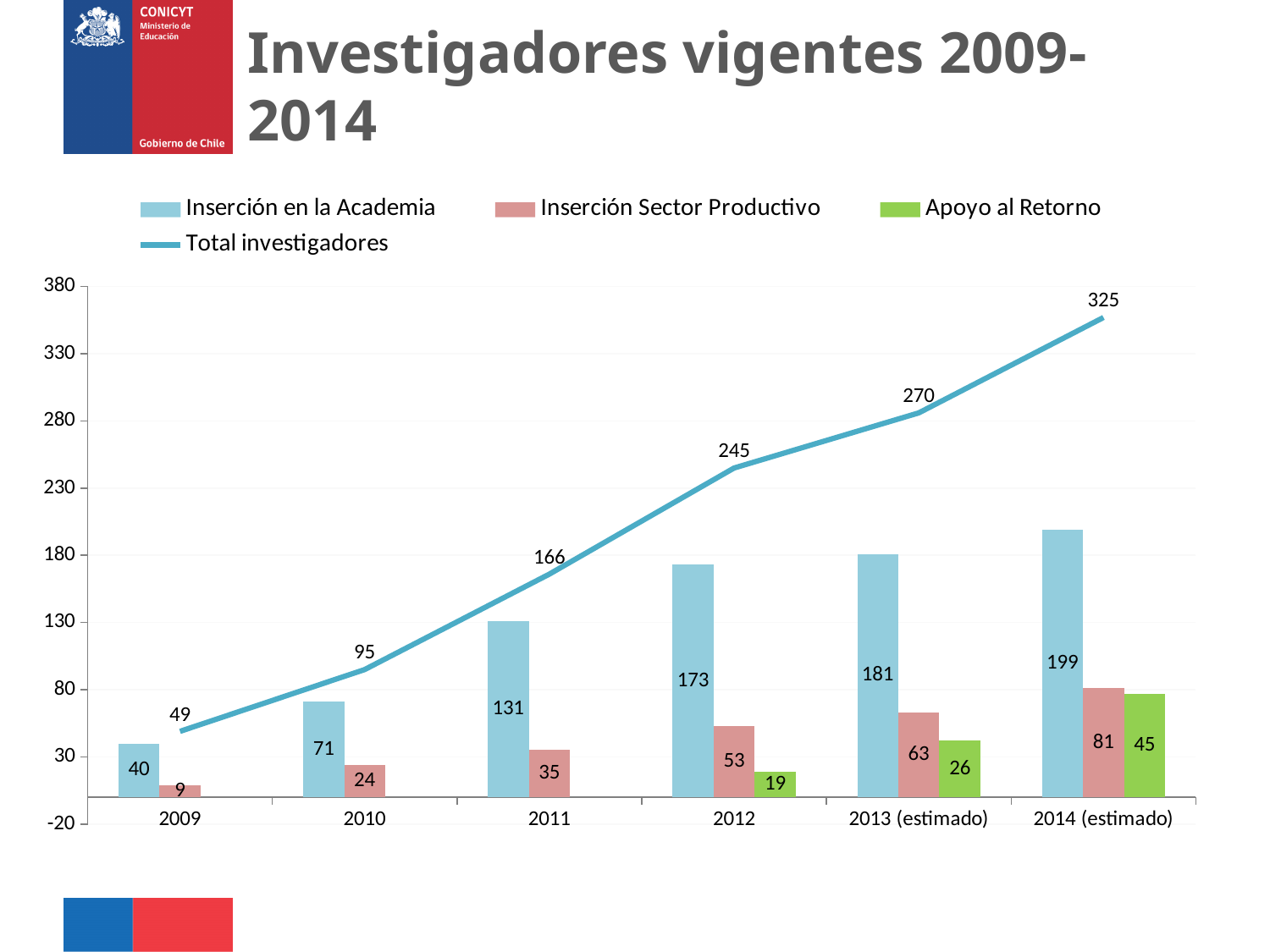
What is the value of Apoyo al Retorno in 2013 (estimado)? 26 What is the Total investigadores value for 2014 (estimado)? 325 Does Total investigadores rise or fall from 2009 to 2014 (estimado)? rise How many years are shown on the x axis? 6 What is the value of Inserción en la Academia in 2011? 131 What is the difference between Total investigadores in 2012 and in 2011? 79 How many series does the legend list? 4 In which year is Total investigadores lowest? 2009 What kind of chart is shown on the slide? combined bar and line chart In which year is Inserción en la Academia highest? 2014 (estimado) What is the value of Inserción Sector Productivo in 2010? 24 Which is larger in 2014 (estimado): Inserción Sector Productivo or Apoyo al Retorno? Inserción Sector Productivo